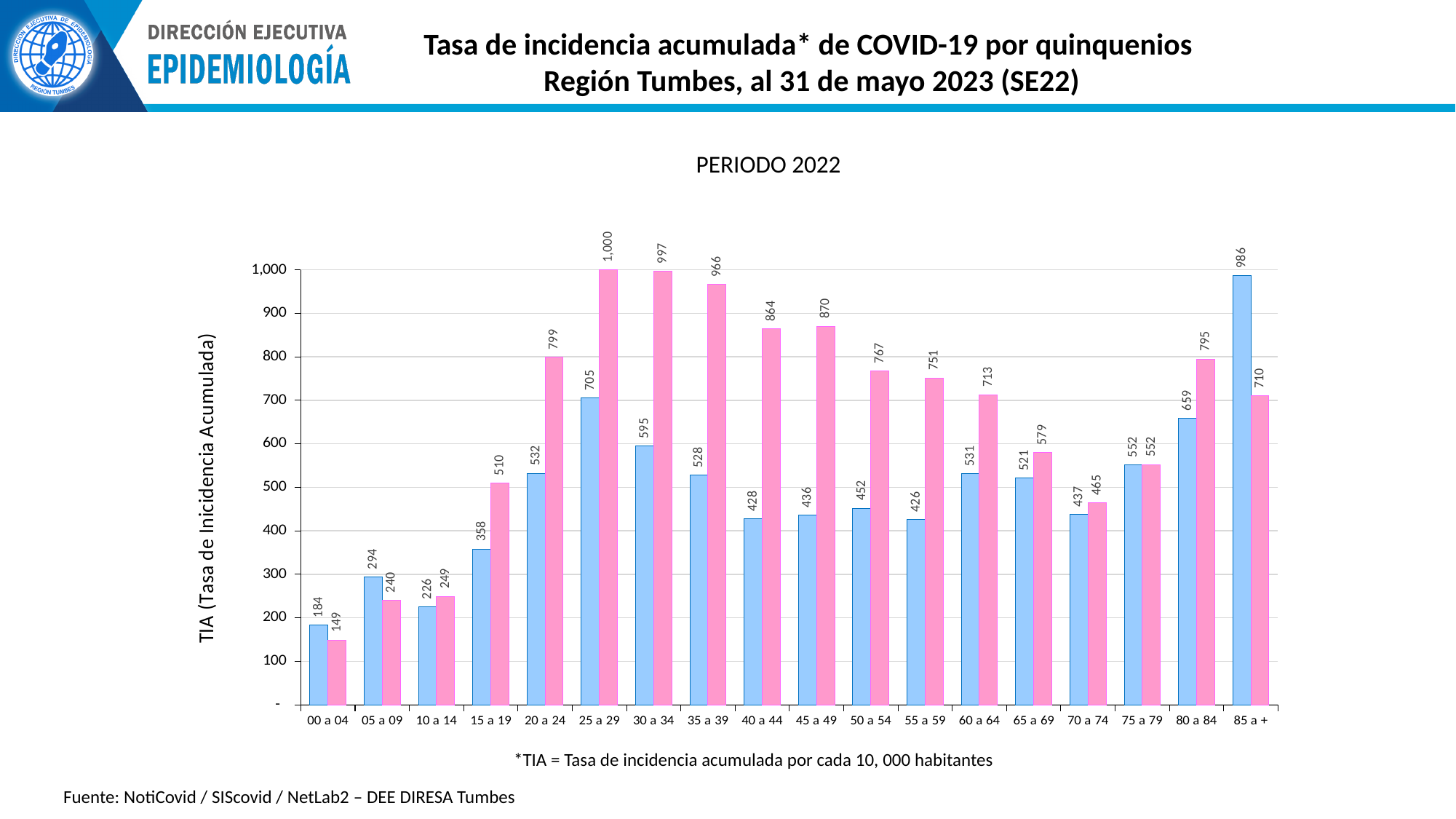
What is the value of the blue bar for the 25 a 29 age group? 705 What kind of chart is shown on the slide? bar chart For the 05 a 09 age group, which bar is larger, the blue one or the pink one? the blue one Which age group has the lowest pink bar? 00 a 04 What is the title shown above the chart? PERIODO 2022 What is the value of the pink bar for the 45 a 49 age group? 870 Which age group has the highest pink bar? 25 a 29 How many age groups (quinquenios) are shown on the x axis? 18 Which age group has the lowest blue bar? 00 a 04 Which age group has the highest blue bar? 85 a + For the 85 a + age group, what is the difference between the blue bar and the pink bar? 276 What is the value of the pink bar for the 80 a 84 age group? 795